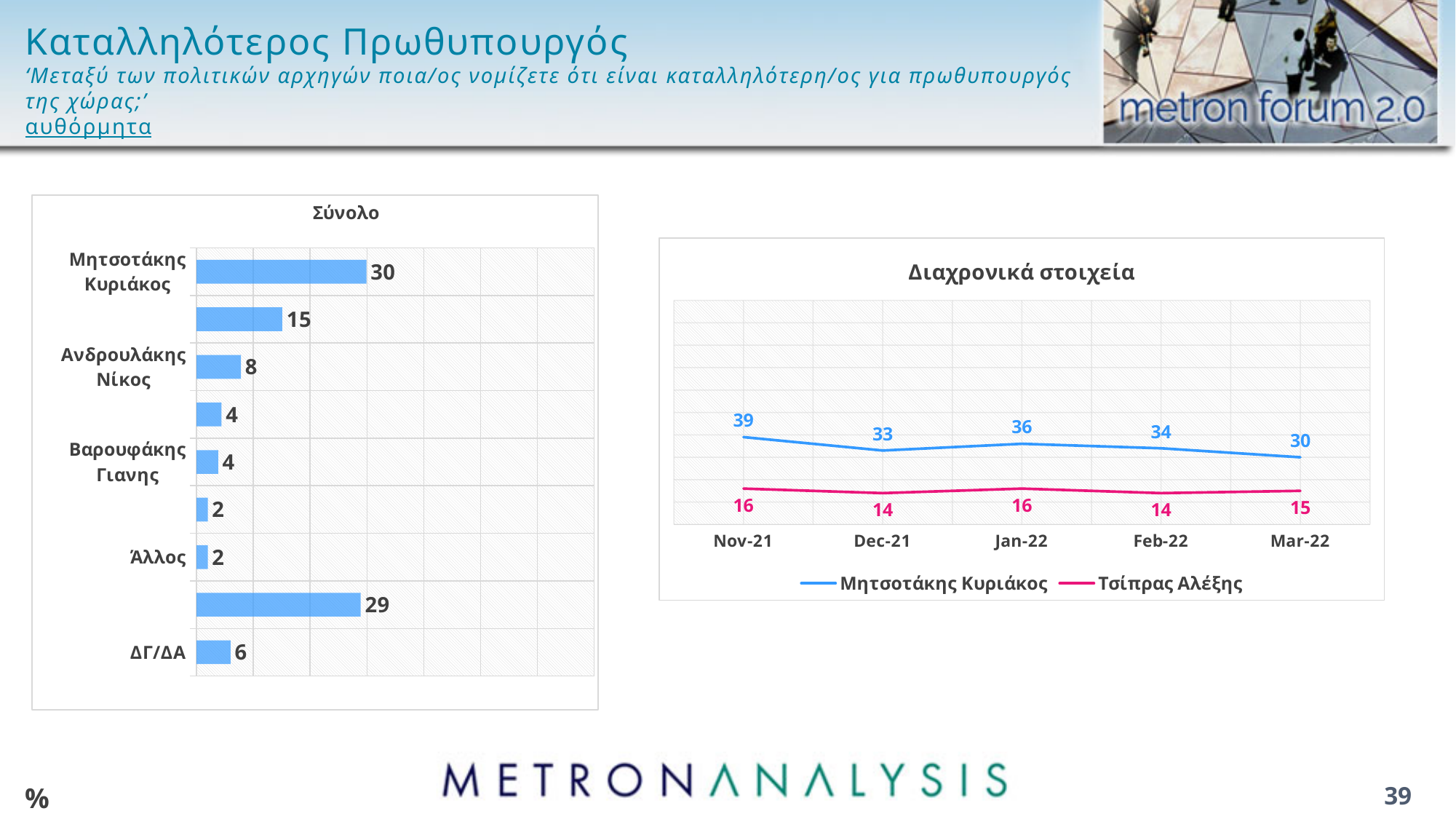
How many time points are plotted on the x axis of the 'Διαχρονικά στοιχεία' chart? 5 What kind of chart is the 'Σύνολο' chart? bar chart In the 'Σύνολο' bar chart, which is larger: the value for Βαρουφάκης Γιανης or the value for Άλλος? Βαρουφάκης Γιανης How many series does the legend of the 'Διαχρονικά στοιχεία' chart list? 2 In the 'Σύνολο' bar chart, what is the value for Μητσοτάκης Κυριάκος? 30 In the 'Διαχρονικά στοιχεία' chart, what is the difference between Μητσοτάκης Κυριάκος and Τσίπρας Αλέξης in Jan-22? 20 In the 'Σύνολο' bar chart, what is the difference between the values for Μητσοτάκης Κυριάκος and Ανδρουλάκης Νίκος? 22 In the 'Διαχρονικά στοιχεία' chart, what is the value for Μητσοτάκης Κυριάκος in Nov-21? 39 In the 'Διαχρονικά στοιχεία' chart, in which month is the value for Μητσοτάκης Κυριάκος highest? Nov-21 In the 'Σύνολο' bar chart, what is the value for ΔΓ/ΔΑ? 6 In the 'Σύνολο' bar chart, what is the value for Ανδρουλάκης Νίκος? 8 In the 'Διαχρονικά στοιχεία' chart, what is the value for Τσίπρας Αλέξης in Mar-22? 15